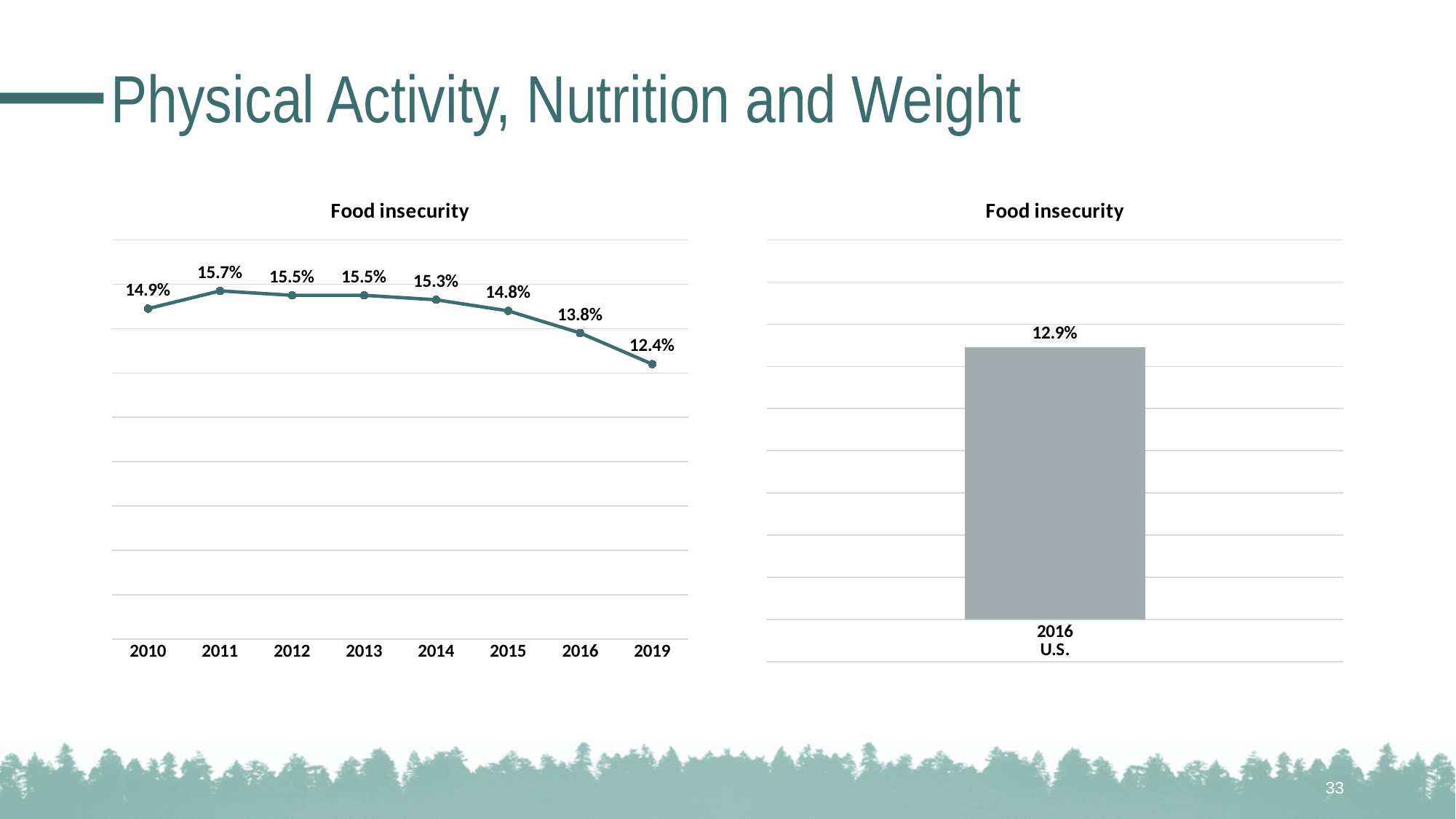
In the left-hand Food insecurity line chart, which is larger, the value for 2014 or the value for 2015? 2014 In the left-hand Food insecurity line chart, what is the difference between the 2011 value and the 2019 value? 3.3% In the left-hand Food insecurity line chart, what is the value for 2019? 12.4% In the left-hand Food insecurity line chart, which year has the lowest value? 2019 In the left-hand Food insecurity line chart, which year has the highest value? 2011 In the left-hand Food insecurity line chart, do the values rise or fall from 2011 to 2019? Fall In the left-hand Food insecurity line chart, what is the value for 2016? 13.8% In the right-hand Food insecurity bar chart, what is the value for 2016 U.S.? 12.9% What kind of chart is the left-hand Food insecurity chart? Line chart What kind of chart is the right-hand Food insecurity chart? Bar chart In the left-hand Food insecurity line chart, what is the value for 2010? 14.9% How many years are plotted in the left-hand Food insecurity line chart? 8